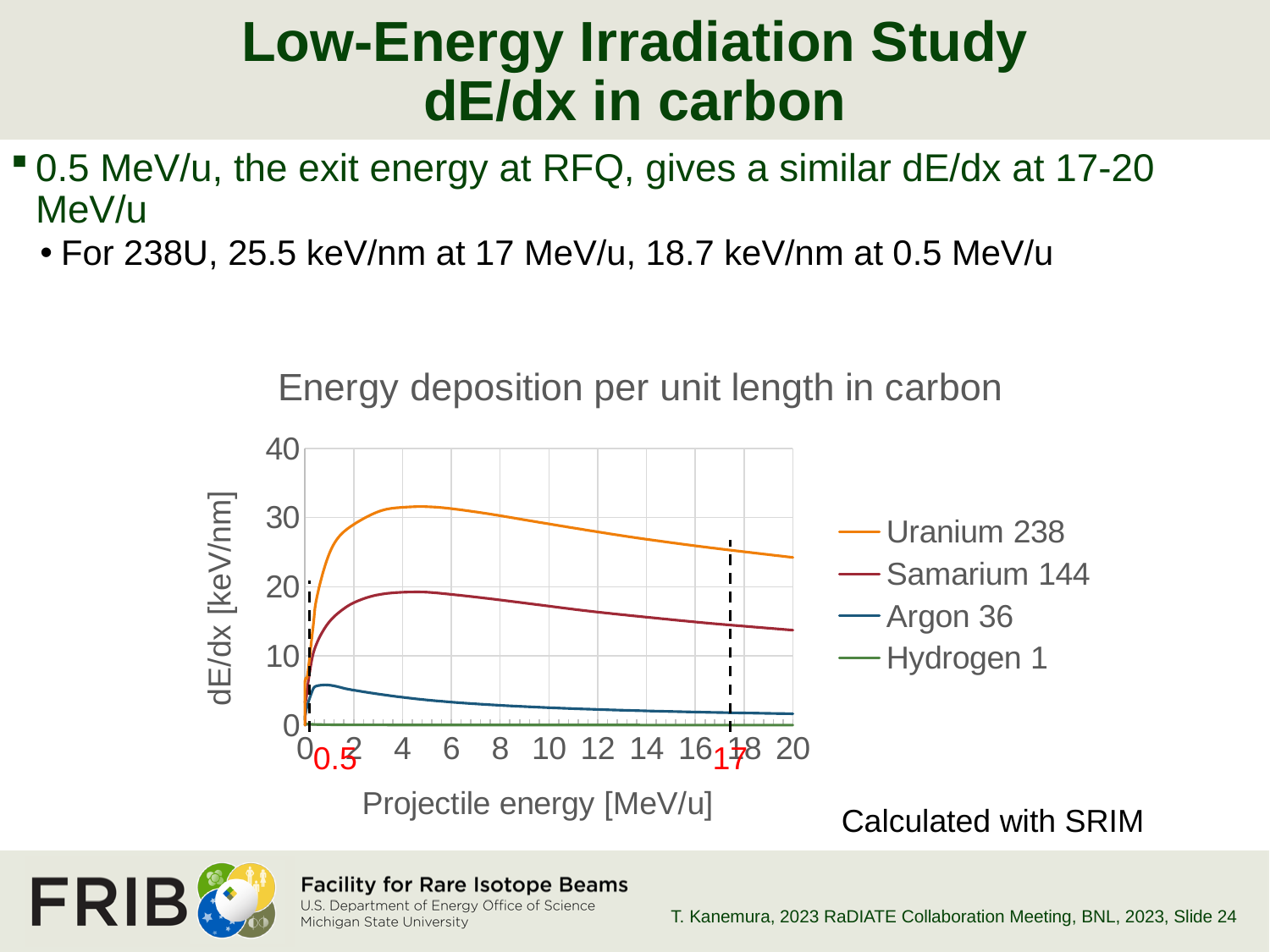
At 10 MeV/u, which series has the larger dE/dx: Samarium 144 or Argon 36? Samarium 144 What kind of chart is shown on the slide? line chart Does the dE/dx for Uranium 238 rise or fall as projectile energy increases from 4 MeV/u to 20 MeV/u? fall Is the dE/dx value for Uranium 238 at 10 MeV/u greater or less than 20 keV/nm? greater According to the slide text, what is the dE/dx for 238U at 0.5 MeV/u? 18.7 keV/nm What is the title of the chart? Energy deposition per unit length in carbon Is the dE/dx value for Argon 36 at 2 MeV/u greater or less than 10 keV/nm? less Which series has the lowest dE/dx values across the plotted energy range? Hydrogen 1 Which series has the highest dE/dx values across the plotted energy range? Uranium 238 Is the dE/dx value for Samarium 144 at 10 MeV/u greater or less than 20 keV/nm? less According to the slide text, what is the dE/dx for 238U at 17 MeV/u? 25.5 keV/nm How many series does the legend of the chart list? 4